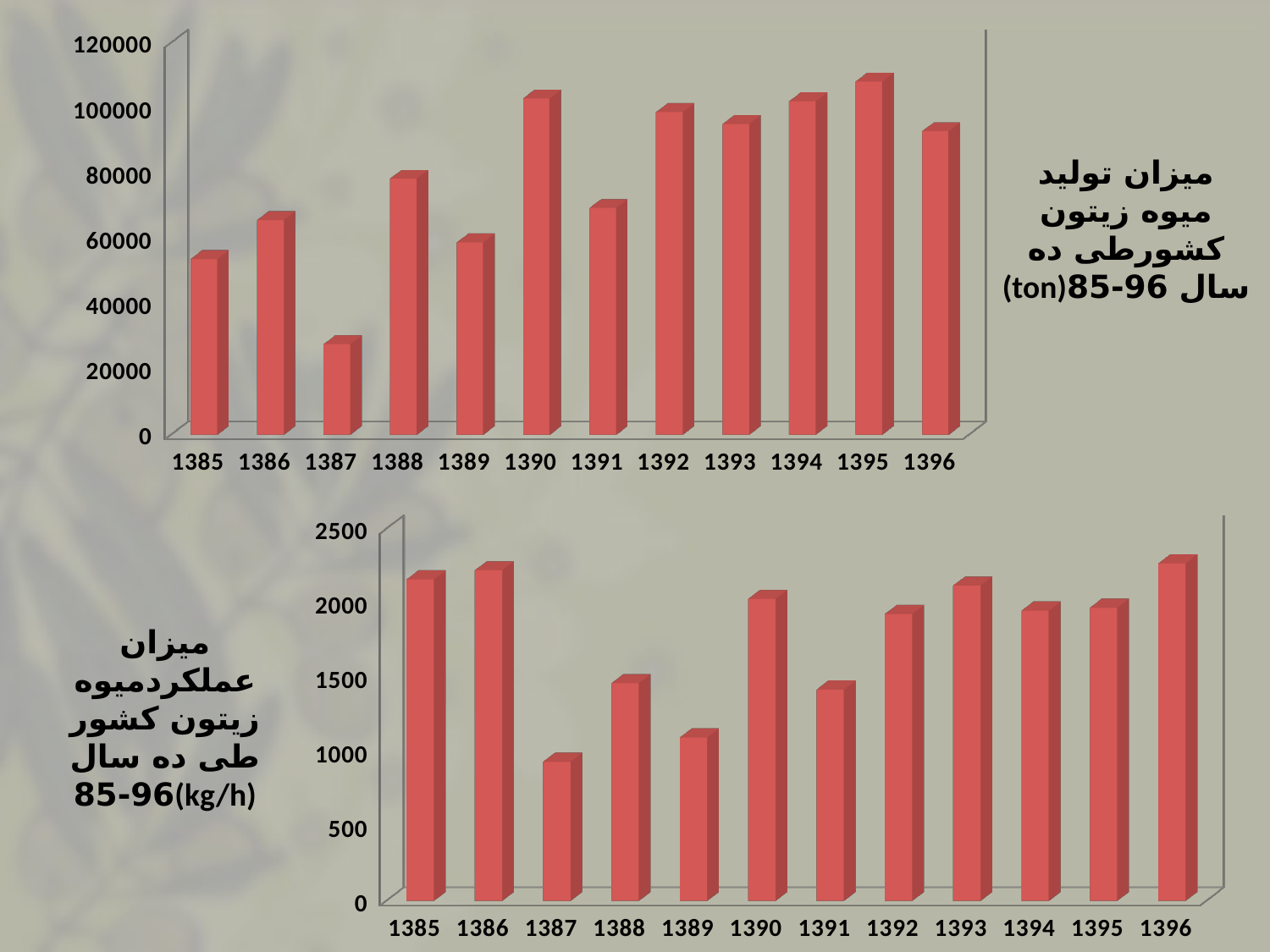
In the bottom chart (olive yield, kg/h), is the value for 1393 greater or less than 2000? greater In the bottom chart (olive yield, kg/h), which year has the lowest value? 1387 In the top chart (olive fruit production, ton), is the value for 1390 greater or less than 100000? greater In the top chart (olive fruit production, ton), which is larger, the value for 1388 or the value for 1389? 1388 In the bottom chart (olive yield, kg/h), is the value for 1389 greater or less than 1500? less What kind of chart is the top chart on the slide? bar chart What unit is given in the title of the bottom chart? kg/h How many years are shown on the x axis of the top chart (olive fruit production, ton)? 12 In the bottom chart (olive yield, kg/h), which is larger, the value for 1390 or the value for 1391? 1390 In the top chart (olive fruit production, ton), which year has the highest value? 1395 In the top chart (olive fruit production, ton), which year has the lowest value? 1387